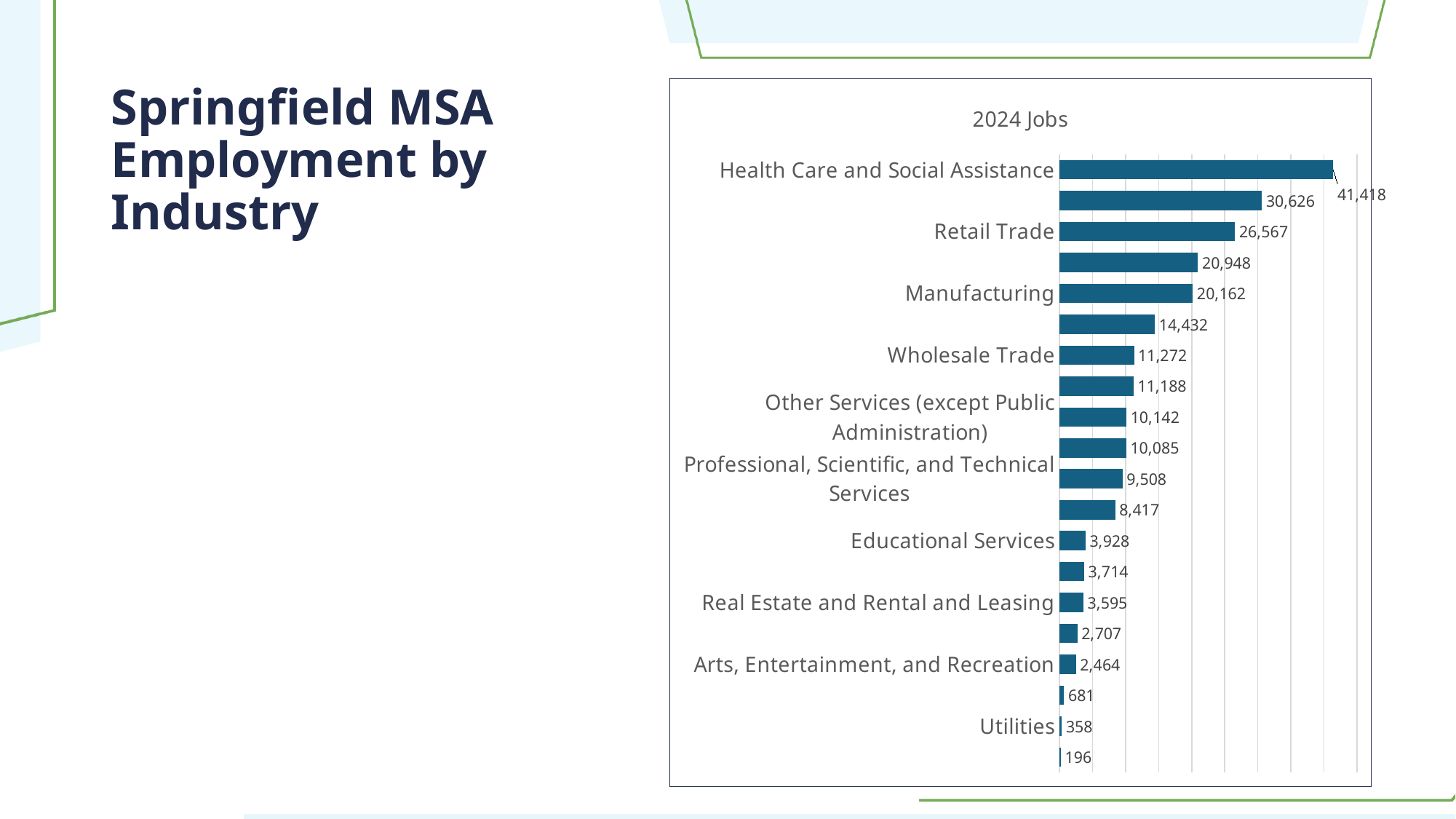
Which is larger, Retail Trade or Manufacturing? Retail Trade Which industry has the highest number of jobs? Health Care and Social Assistance What is the value for Utilities? 358 What is the value for Retail Trade? 26,567 What is the value for Manufacturing? 20,162 What is the value for Health Care and Social Assistance? 41,418 What is the value for Wholesale Trade? 11,272 How many bars are shown in the chart? 20 What is the difference between Manufacturing and Wholesale Trade? 8,890 What is the difference between Health Care and Social Assistance and Retail Trade? 14,851 What is the value for Educational Services? 3,928 What type of chart is shown? Bar chart